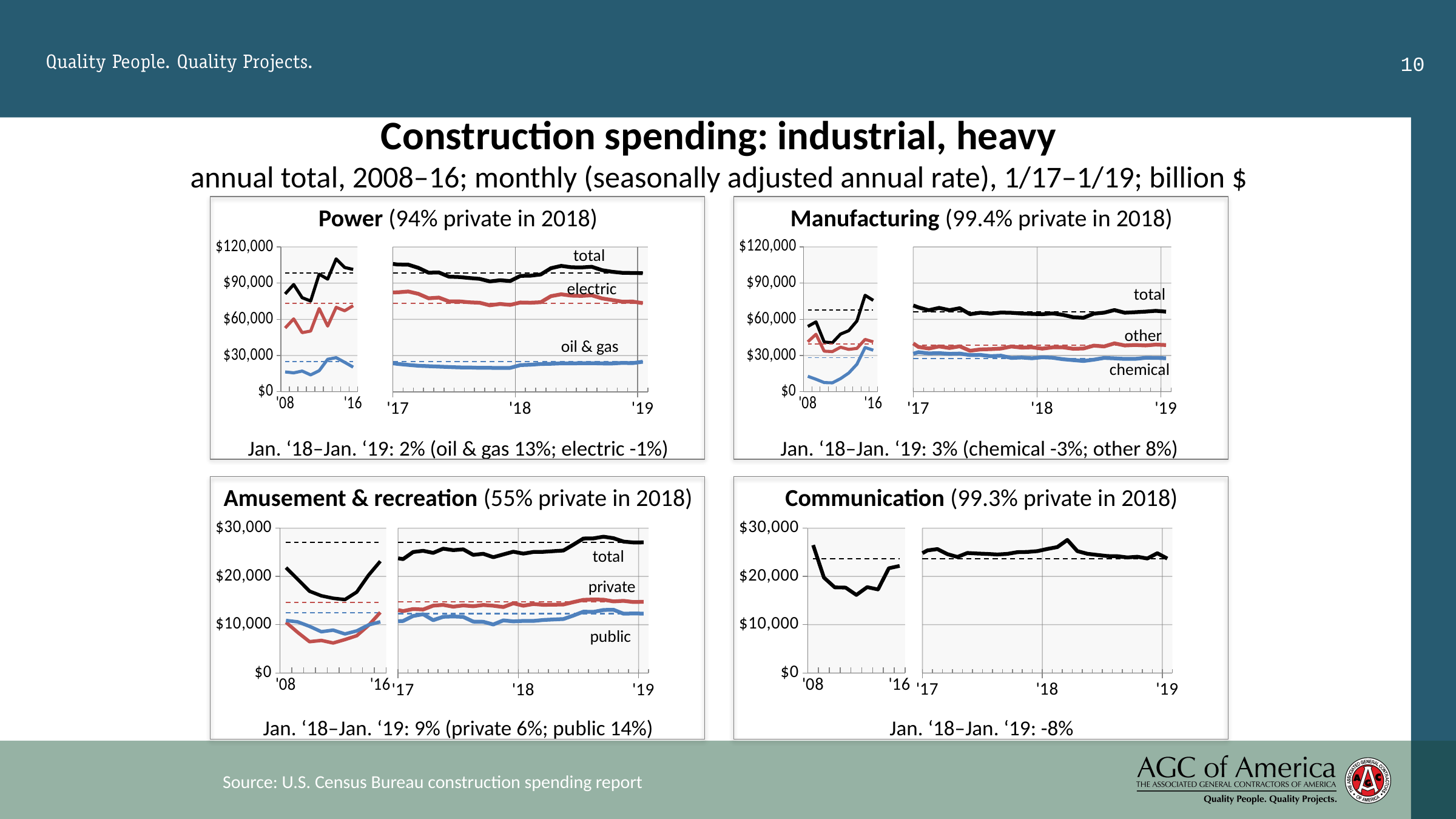
On the Amusement & recreation chart, is the public value at '17 greater or less than $20,000? less On the Power chart, is the oil & gas value at '17 greater or less than $30,000? less On the Manufacturing chart, is the total value at '19 greater or less than $60,000? greater On the Power chart, which series is larger at '19: electric or oil & gas? electric According to the Communication chart's caption, what was the change from Jan. '18 to Jan. '19? -8% How many series are labelled on the Manufacturing chart? 3 What kind of chart is the Power chart? line chart How many series are labelled on the Power chart? 3